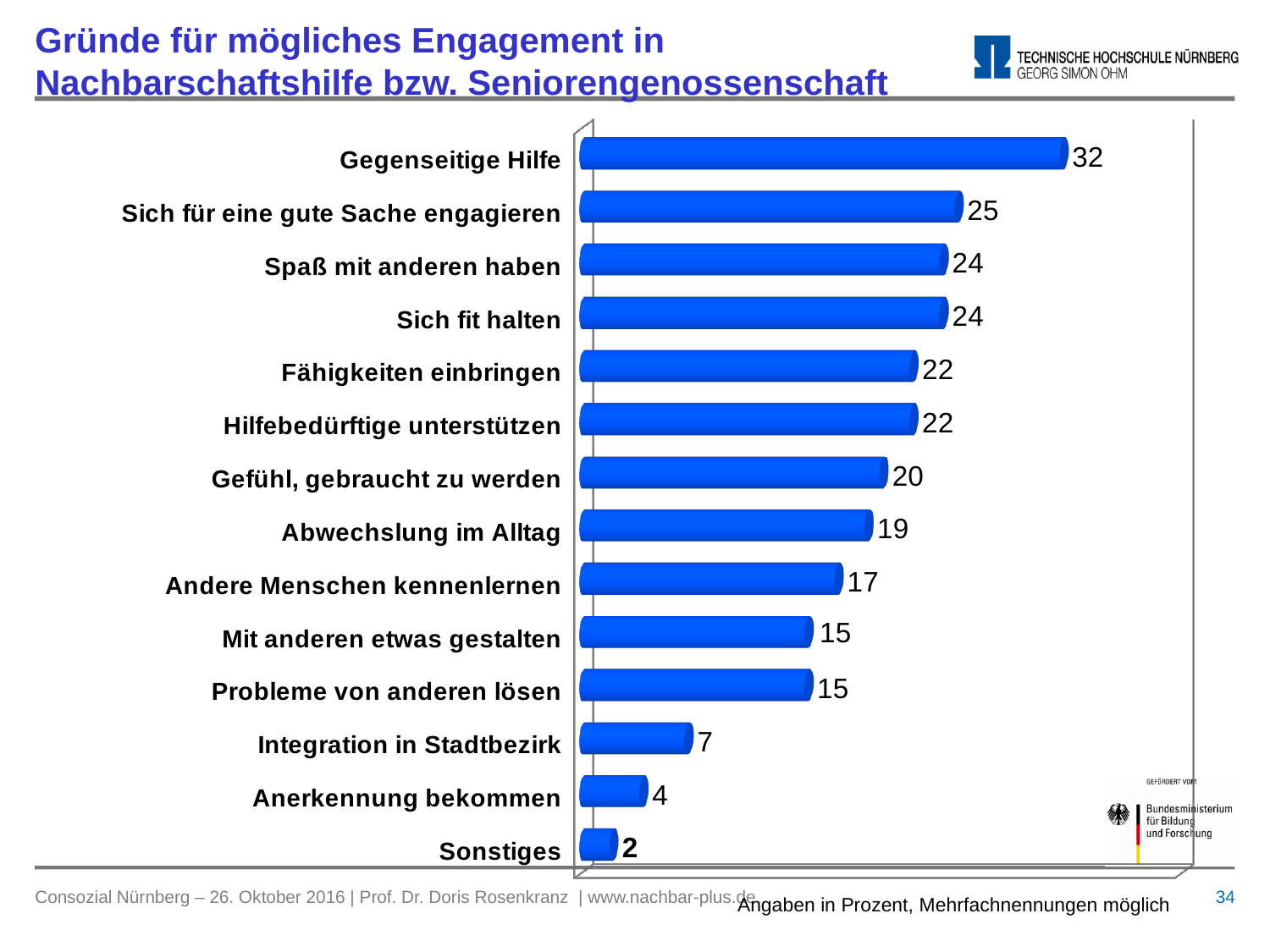
What is the difference between the values for "Gegenseitige Hilfe" and "Sich für eine gute Sache engagieren"? 7 How many categories are shown in the chart? 14 What is the value for "Sonstiges"? 2 What is the value for "Fähigkeiten einbringen"? 22 Which category has the lowest value? Sonstiges Which category has the highest value? Gegenseitige Hilfe What colour are the bars in the chart? Blue What is the difference between the values for "Abwechslung im Alltag" and "Anerkennung bekommen"? 15 What kind of chart is shown on the slide? Bar chart Which is larger, the value for "Gefühl, gebraucht zu werden" or the value for "Andere Menschen kennenlernen"? Gefühl, gebraucht zu werden What is the value for "Integration in Stadtbezirk"? 7 What is the value for "Gegenseitige Hilfe"? 32